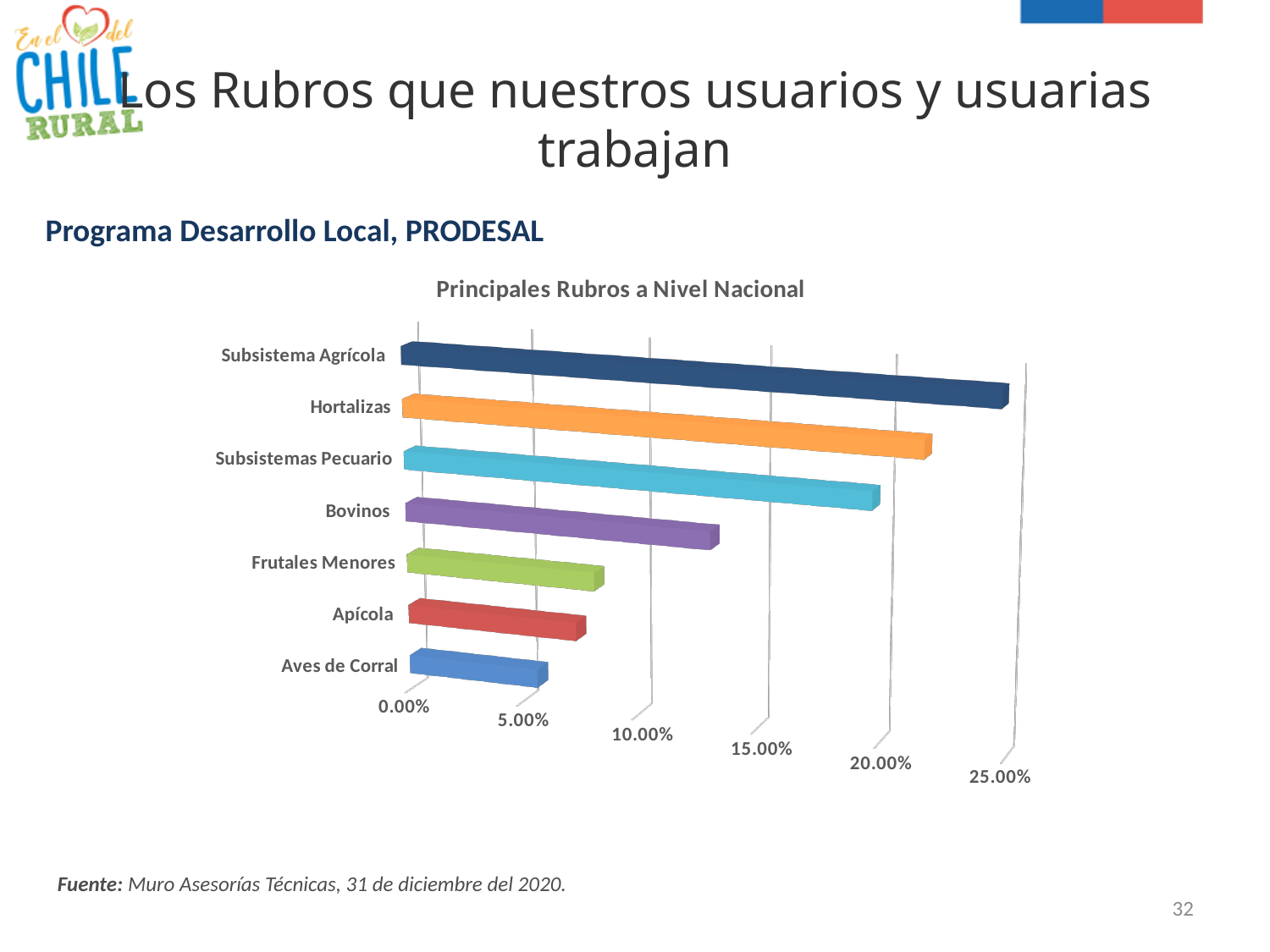
Is the value for Subsistemas Pecuario greater or less than 15.00%? greater Which is larger, the value for Bovinos or the value for Frutales Menores? Bovinos Is the value for Bovinos greater or less than 10.00%? greater Which category has the lowest value in the chart? Aves de Corral What kind of chart is shown on the slide? bar chart Is the value for Aves de Corral greater or less than 10.00%? less Which category has the highest value in the chart? Subsistema Agrícola How many categories (rubros) are shown in the chart? 7 What is the title of the chart? Principales Rubros a Nivel Nacional Which is larger, the value for Hortalizas or the value for Subsistemas Pecuario? Hortalizas